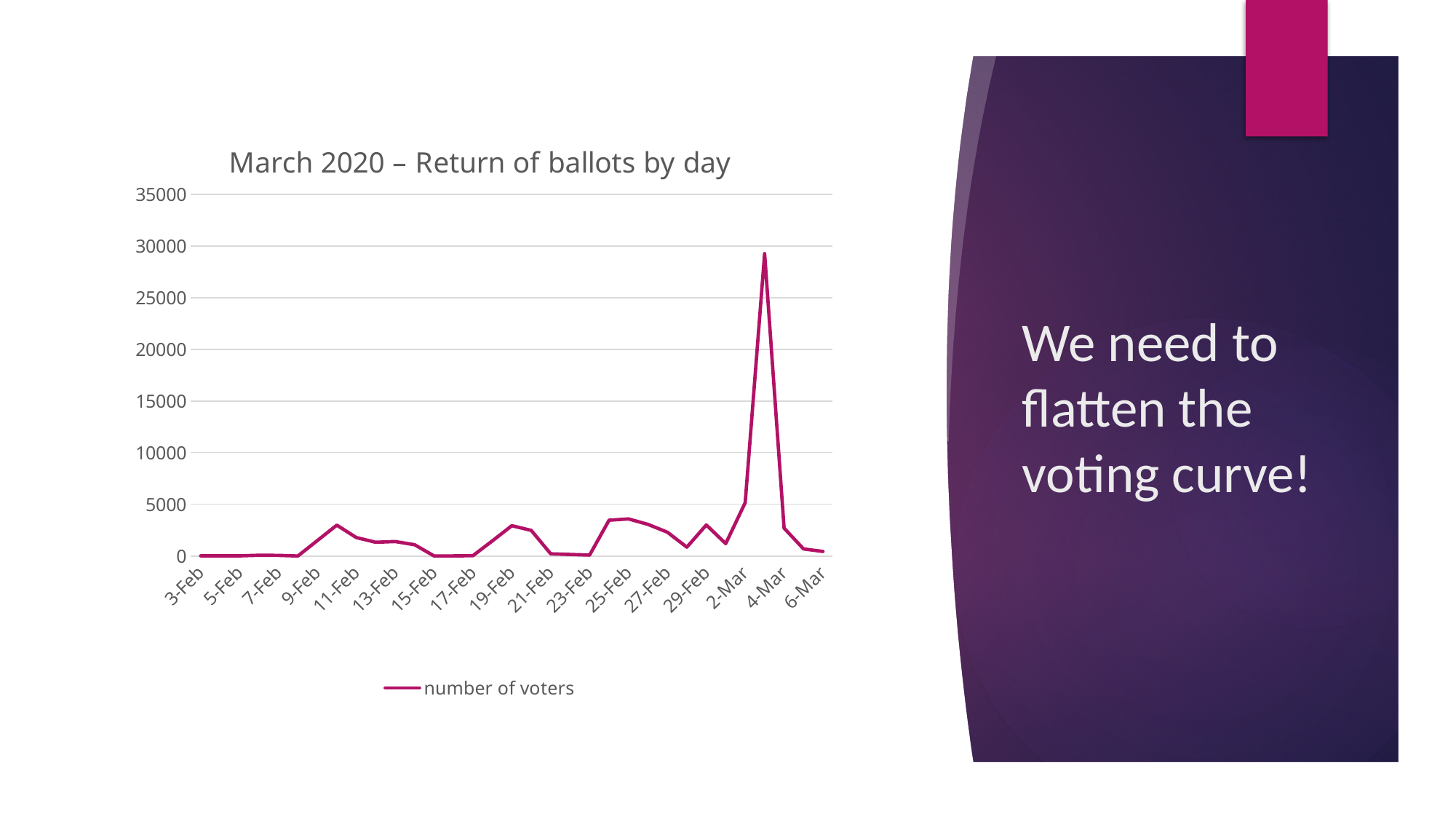
Does the highest number of voters occur in February or in March? March Is the value for 6-Mar greater or less than 5000? less Is the peak value of the number of voters greater or less than 25000? greater What is the title of the chart? March 2020 – Return of ballots by day Does the number of voters rise or fall from 4-Mar to 6-Mar? fall How many date labels are shown on the x axis? 17 Is the value for 3-Feb greater or less than 5000? less What kind of chart is shown on the slide? line chart What is the name of the series shown in the legend? number of voters Which has the larger value, 11-Feb or 3-Feb? 11-Feb How many series does the chart's legend list? 1